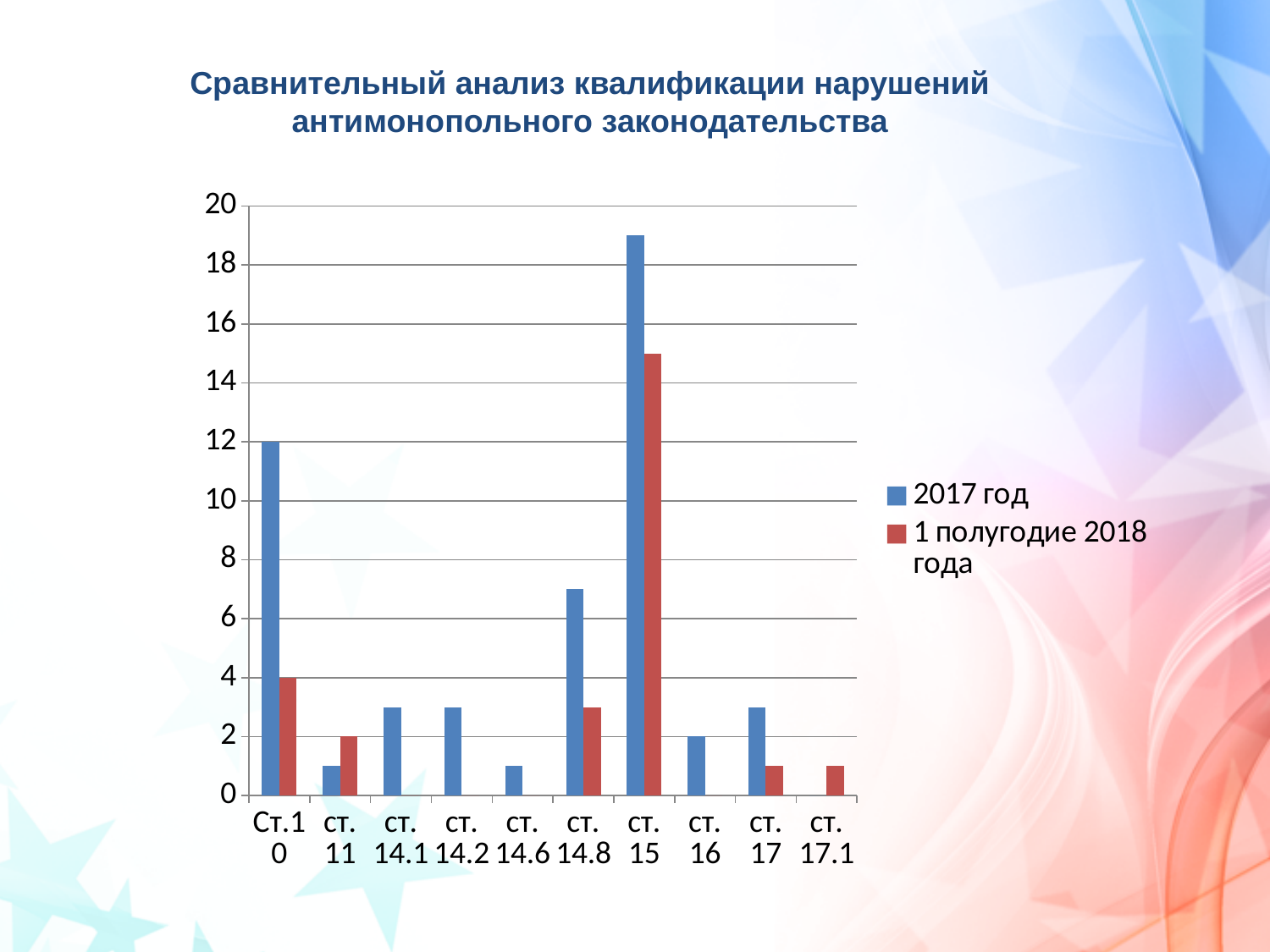
Is the value for ст. 14.8 in the 2017 год series greater or less than 6? greater What is the value for Ст.10 in the 2017 год series? 12 How many series does the legend list? 2 What type of chart is shown on the slide? bar chart What is the value for ст. 16 in the 2017 год series? 2 For ст. 15, which series has the larger value, 2017 год or 1 полугодие 2018 года? 2017 год What is the value for Ст.10 in the 1 полугодие 2018 года series? 4 Which category has the highest value in the 1 полугодие 2018 года series? ст. 15 Which category has the highest value in the 2017 год series? ст. 15 What is the value for ст. 11 in the 1 полугодие 2018 года series? 2 What is the difference between the 2017 год and 1 полугодие 2018 года values for Ст.10? 8 How many categories are shown on the x axis? 10